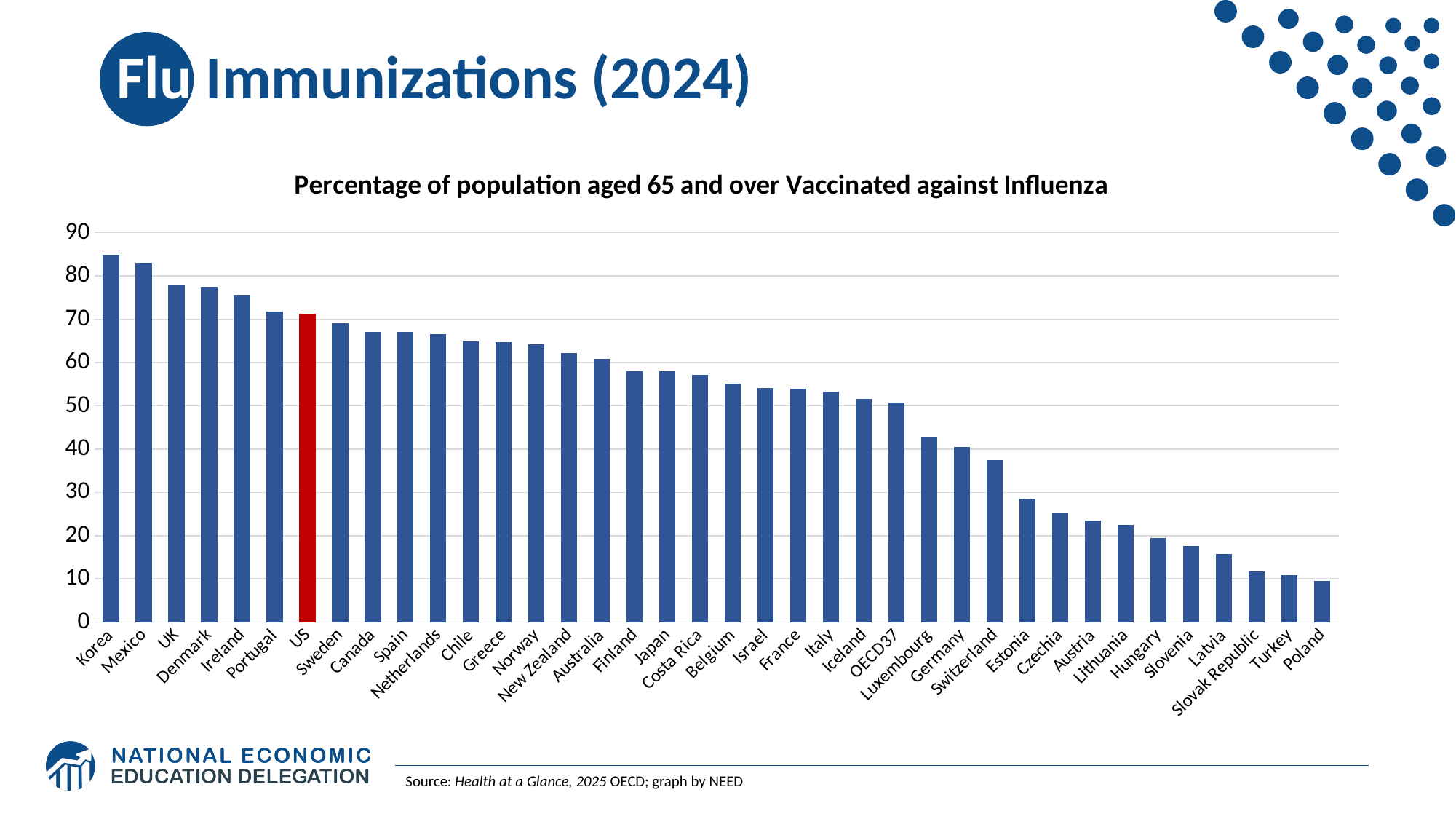
Which country has the highest percentage of population aged 65 and over vaccinated against influenza? Korea Which bar is highlighted in red on the chart? US How many bars (countries and groups) are plotted on the chart? 38 What kind of chart is shown on the slide? bar chart Is the value for Korea greater or less than 80? greater Is the value for Switzerland greater or less than 40? less Is the value for the US greater or less than 60? greater Which has a higher vaccination percentage, the US or Germany? US Do the values rise or fall moving from left to right along the x axis? fall Which country has the lowest percentage of population aged 65 and over vaccinated against influenza? Poland